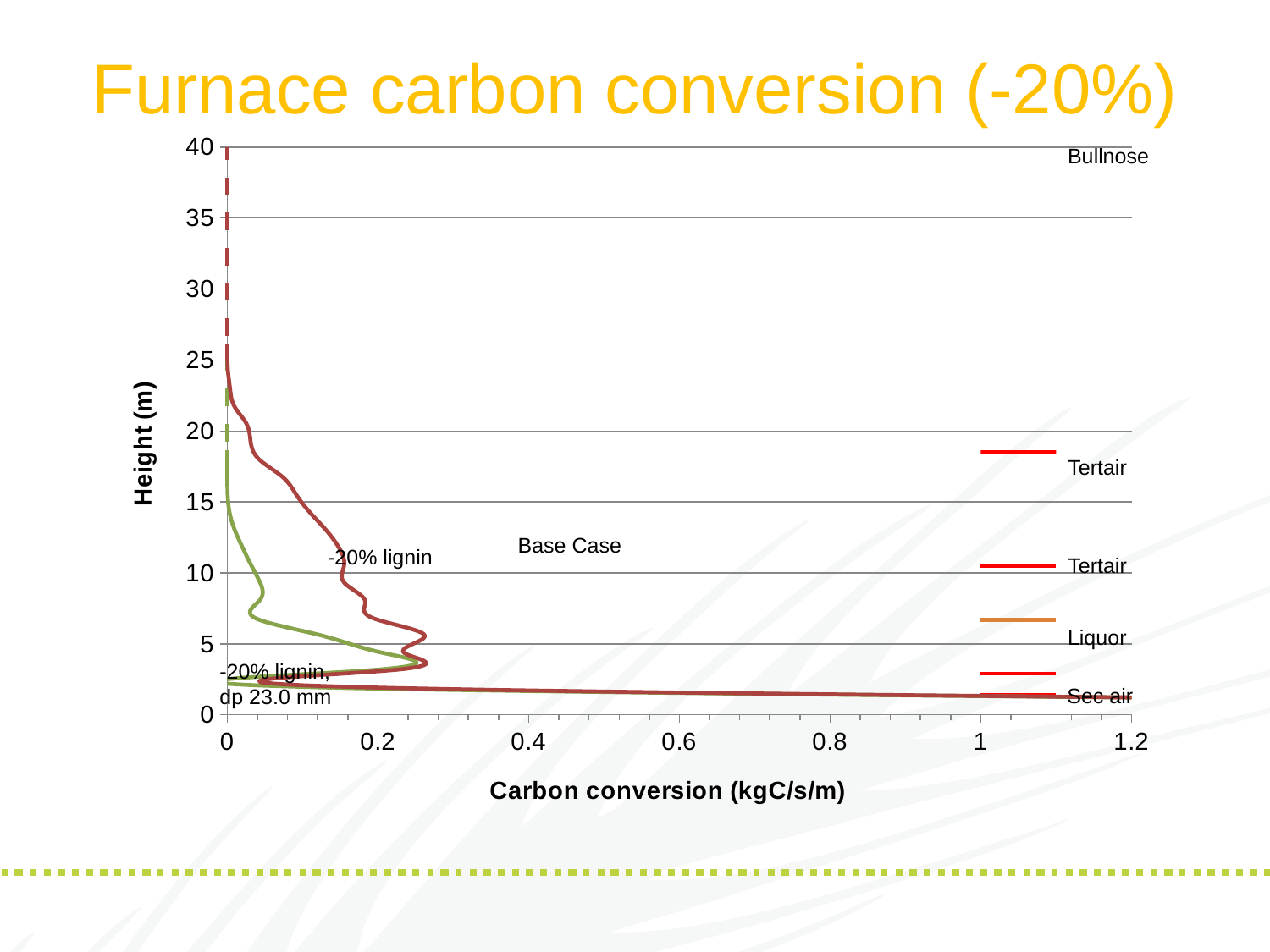
What is the maximum value shown on the vertical axis (Height) of the chart? 40 What is the maximum value shown on the horizontal axis of the chart? 1.2 How many furnace level markers (Bullnose, Tertair, Liquor, Sec air) are labelled on the right side of the chart? 5 What is the title of the chart on the slide? Furnace carbon conversion (-20%) What is the label of the horizontal axis of the chart? Carbon conversion (kgC/s/m) Is the carbon conversion of the '-20% lignin, dp 23.0 mm' line at a height of 10 m greater or less than 0.2? less At a height of 10 m, which line shows the larger carbon conversion: '-20% lignin' or '-20% lignin, dp 23.0 mm'? -20% lignin Is the carbon conversion of the '-20% lignin' line at a height of about 5 m greater or less than 0.2? greater Is the carbon conversion at a height of 30 m greater or less than 0.2? less What kind of chart is shown on the slide? Line chart Above a height of about 5 m, does carbon conversion rise or fall as height increases? Fall